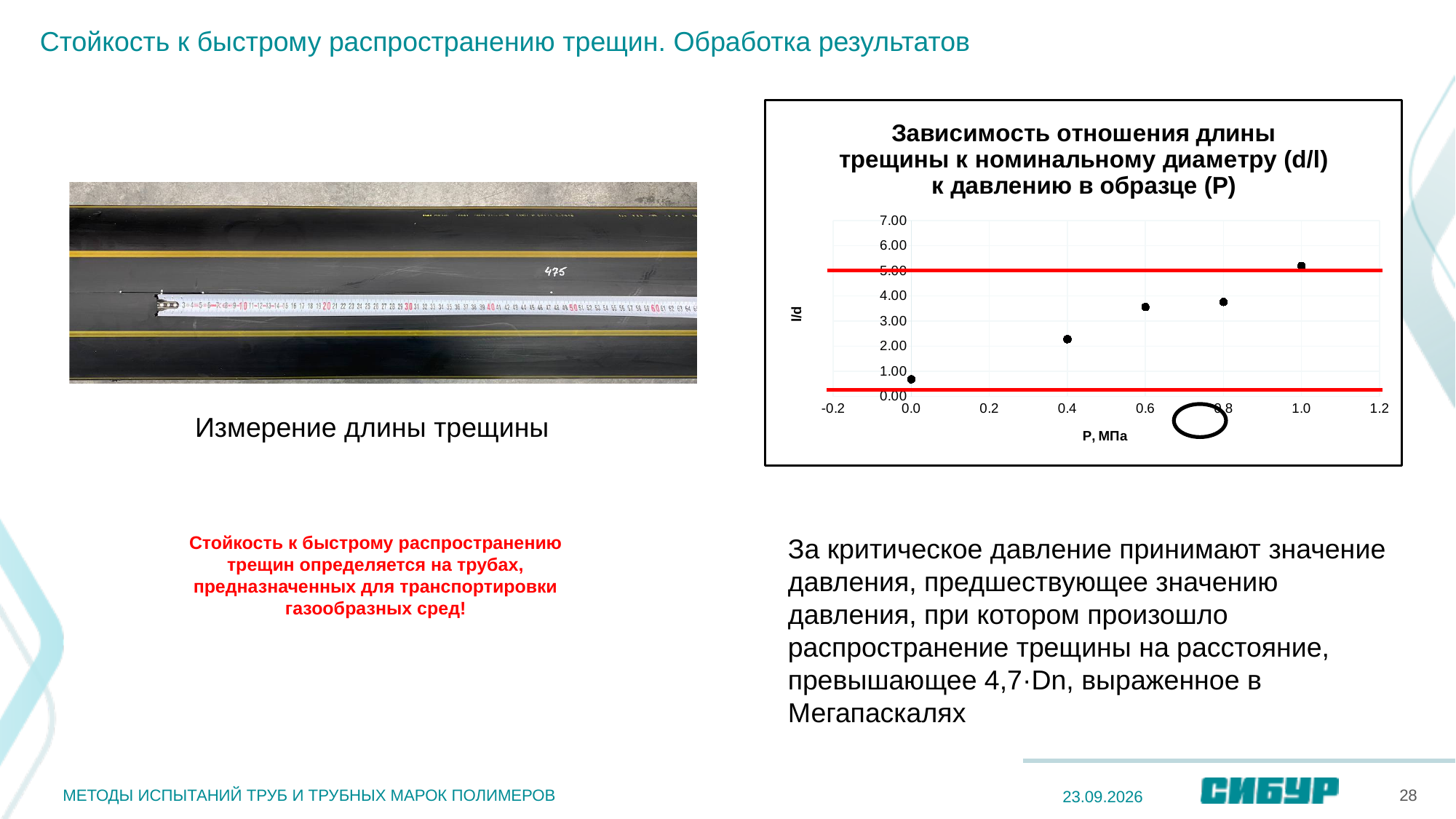
Is the l/d value at P = 0.0 МПа greater or less than 1.00? less What kind of chart is shown on the slide? scatter chart Which has the larger l/d value: the point at P = 0.4 МПа or the point at P = 1.0 МПа? P = 1.0 МПа Is the l/d value at P = 0.4 МПа greater or less than 3.00? less What is the label of the x axis of the chart? P, МПа What is the label of the y axis of the chart? l/d At which value of P (МПа) is the plotted l/d value highest? 1.0 How many data points are plotted on the chart? 5 Do the plotted l/d values rise or fall as pressure P increases along the x axis? rise Is the l/d value at P = 1.0 МПа greater or less than 5.00? greater At which value of P (МПа) is the plotted l/d value lowest? 0.0